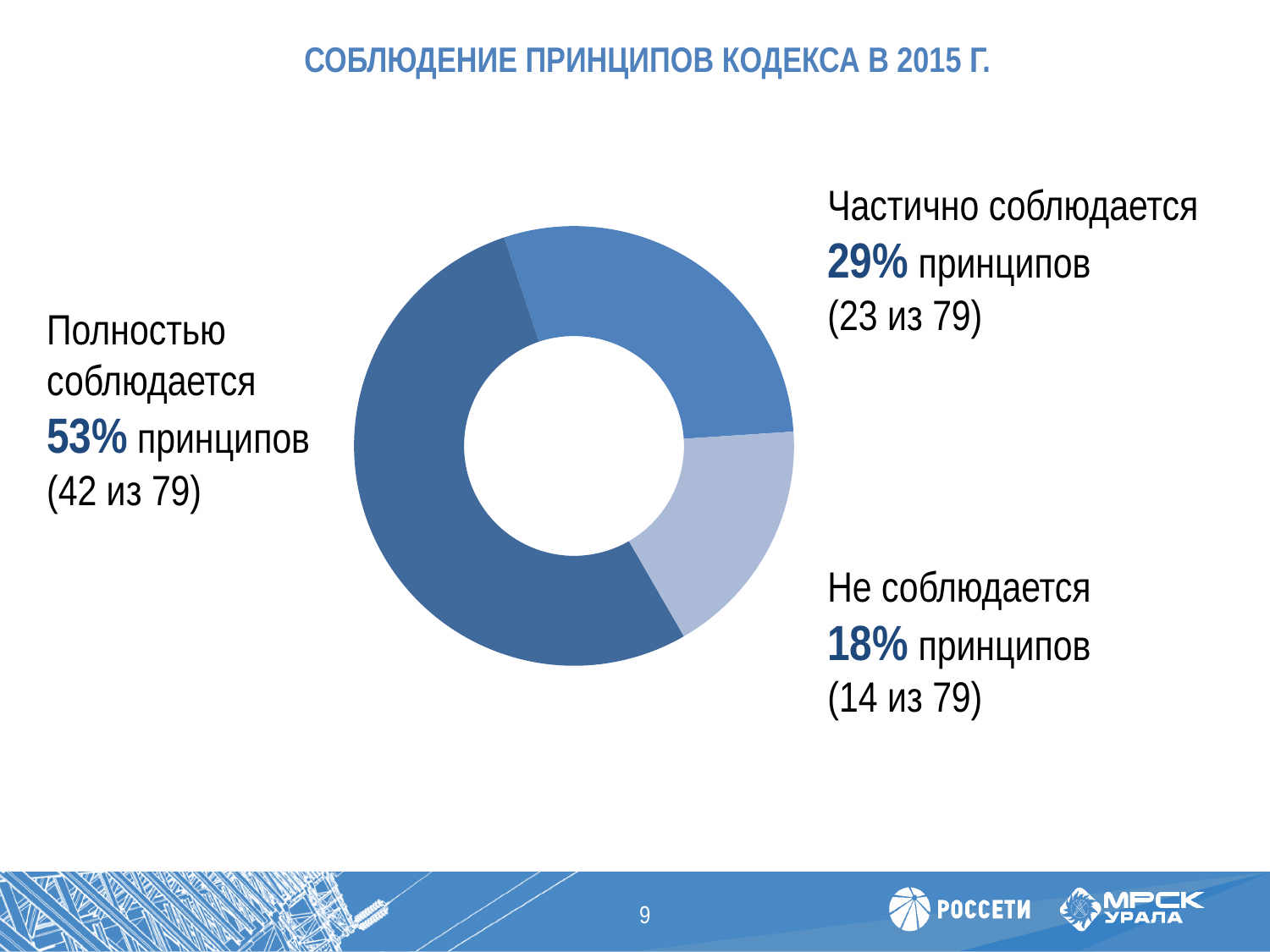
How many categories does the chart show? 3 Which category has the largest share of the chart? Полностью соблюдается Which category has the smallest share of the chart? Не соблюдается How many principles are fully complied with, out of 79? 42 What kind of chart is shown on the slide? Doughnut (pie) chart Which is larger: the share of partially complied principles or the share of not complied principles? Частично соблюдается What share of principles is not complied with (Не соблюдается)? 18% What is the difference in percentage points between fully complied and partially complied principles? 24 What share of principles is fully complied with (Полностью соблюдается)? 53% What share of principles is partially complied with (Частично соблюдается)? 29% How many principles are not complied with, out of 79? 14 How many principles are partially complied with, out of 79? 23